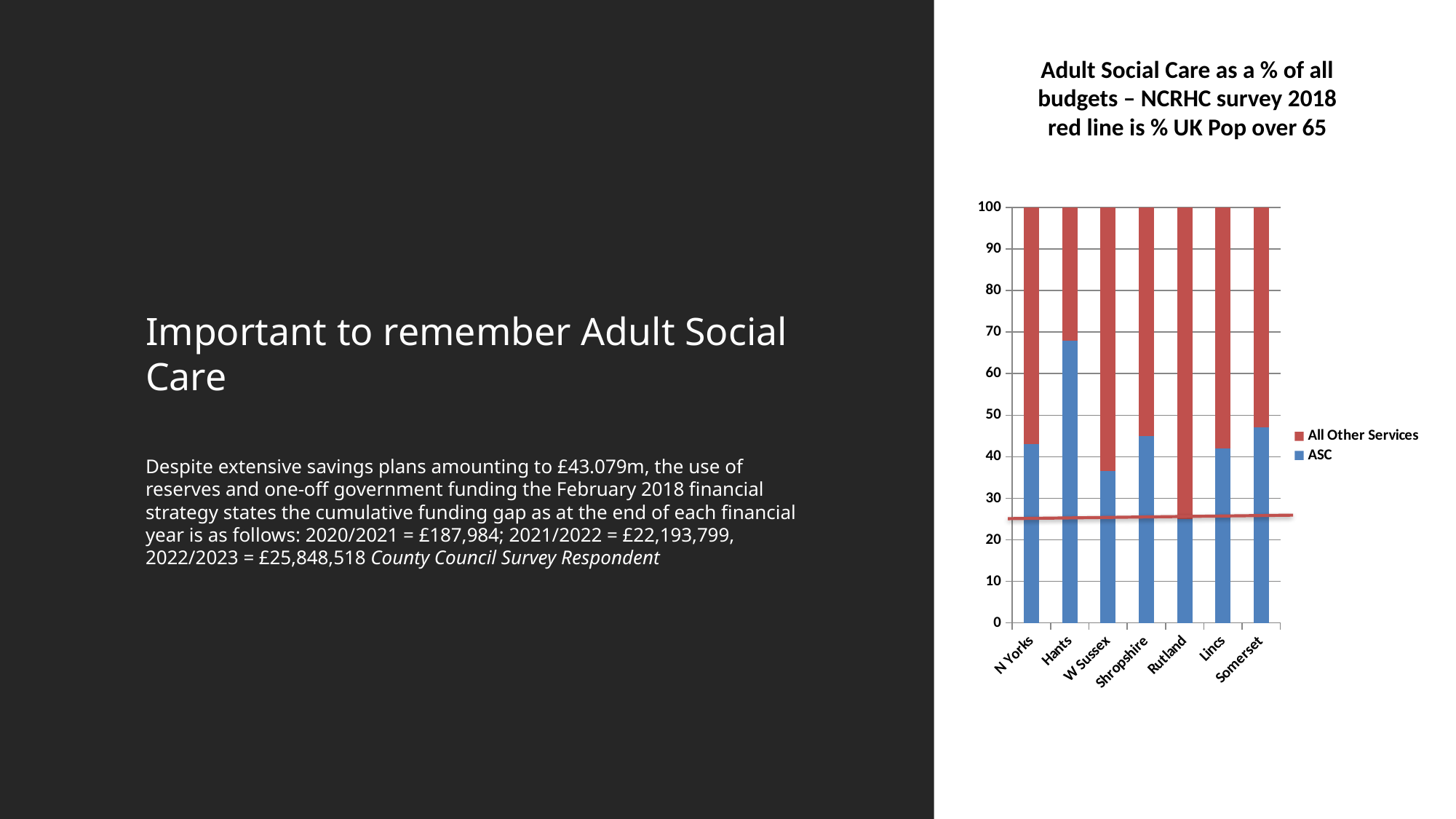
Is the ASC value for Rutland greater or less than 30? less Is the ASC value for Hants greater or less than 60? greater Which county has the highest ASC share of its budget? Hants What is the total height of each stacked bar in the chart? 100 According to the chart title, what does the red line represent? % UK Pop over 65 How many counties are shown on the x axis of the chart? 7 Is the ASC value for W Sussex greater or less than 40? less Which has a larger ASC share, Hants or W Sussex? Hants How many series does the chart's legend list? 2 Which county has the lowest ASC share of its budget? Rutland What kind of chart is shown on the slide? Stacked bar chart